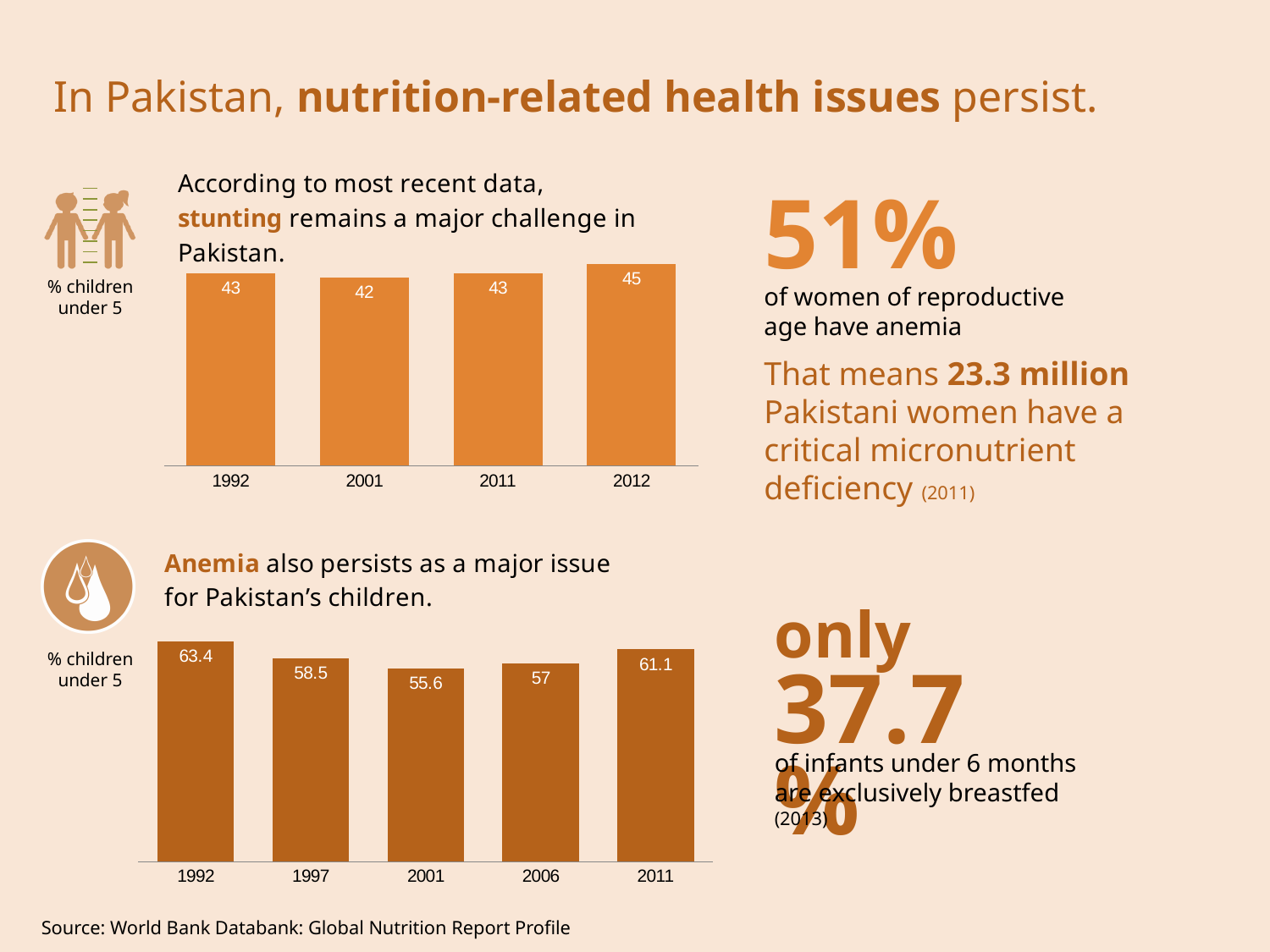
In the top chart on stunting, which year has the highest value? 2012 In the top chart on stunting, what is the difference between the 2012 and 2001 values? 3 In the top chart on stunting, what is the value for 2012? 45 In the top chart on stunting, what is the value for 2001? 42 In the bottom chart on anemia in children, what is the difference between the 1992 and 2001 values? 7.8 In the bottom chart on anemia in children, which year has the lowest value? 2001 In the top chart on stunting, which year has the lowest value? 2001 In the bottom chart on anemia in children, what is the value for 2006? 57 In the top chart on stunting, how many years are shown? 4 In the bottom chart on anemia in children, is the value for 2011 larger or smaller than the value for 1997? larger In the bottom chart on anemia in children, what is the value for 1992? 63.4 What type of chart is the bottom chart on anemia in children? bar chart